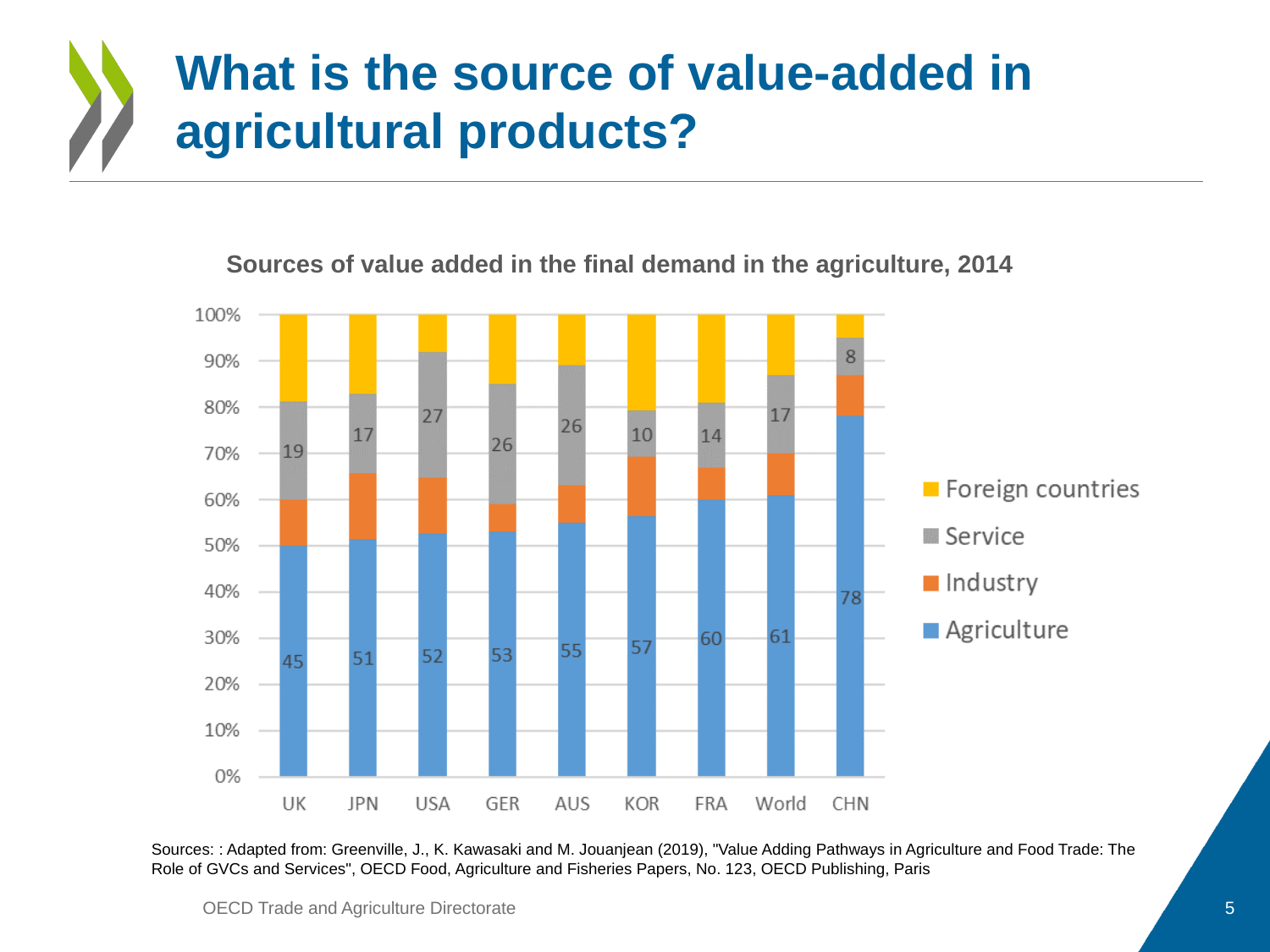
Which country has the highest Agriculture value? CHN Is the Foreign countries share for CHN greater or less than 10%? less What is the Service value for USA? 27 What kind of chart is shown on the slide? Stacked bar chart Do the Agriculture values rise or fall moving from UK to CHN along the x axis? rise How many countries/regions are shown along the x axis of the chart? 9 What is the Agriculture value for CHN? 78 Is the Service value larger for USA or for GER? USA How many series does the legend list? 4 What is the difference between the Agriculture value for CHN and the Agriculture value for UK? 33 Which category has the lowest Service value? CHN Which country has the lowest Agriculture value? UK